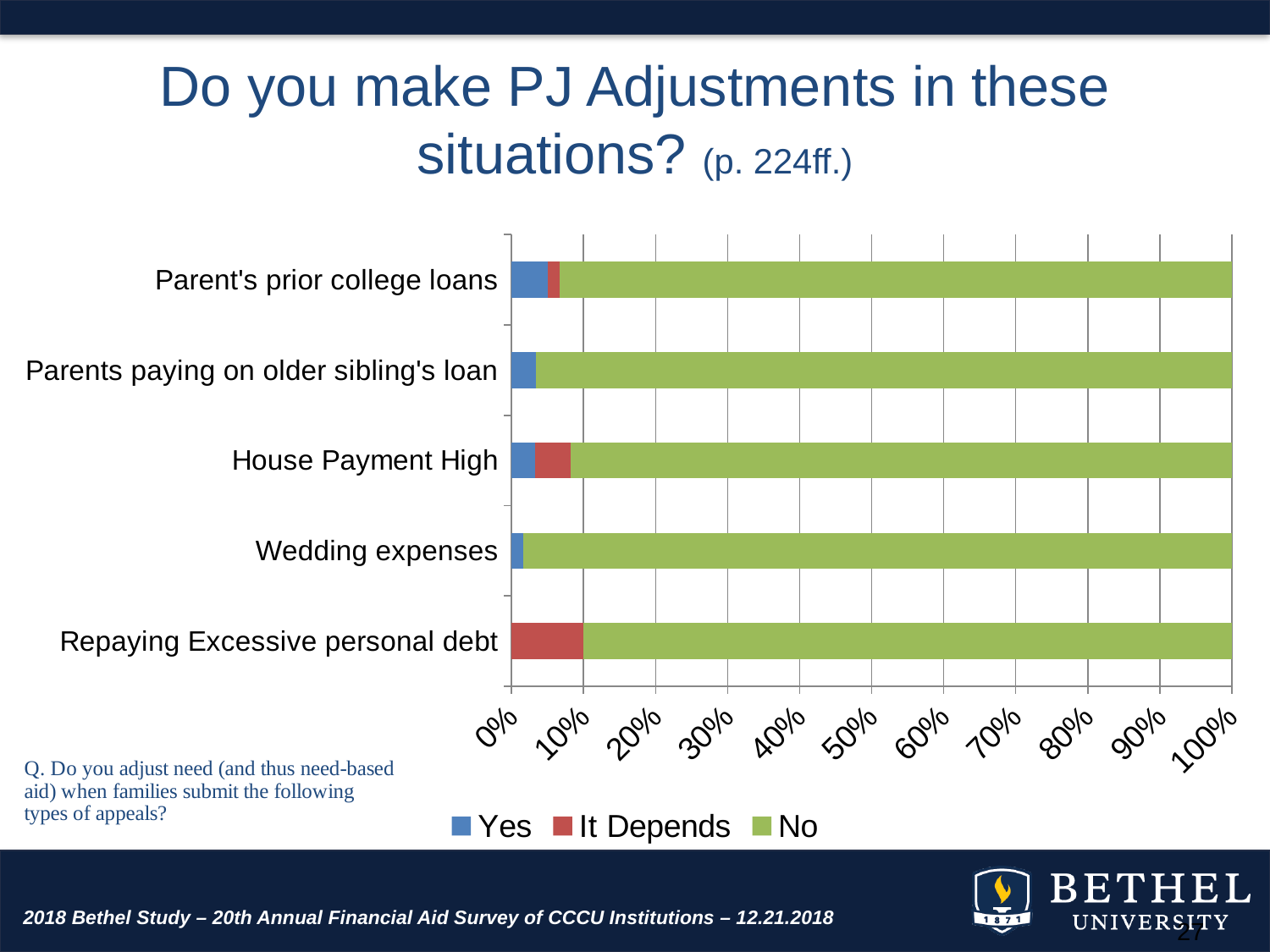
Is the "Yes" value for Parent's prior college loans greater or less than 10%? less Which colour represents the "No" responses in the chart? Green Is the "It Depends" value for Repaying Excessive personal debt greater or less than 20%? less Which category has the largest "It Depends" segment? Repaying Excessive personal debt Which category has the largest "No" segment? Wedding expenses How many series does the chart legend list? 3 What kind of chart is shown on the slide? Stacked bar chart What are the three series named in the legend? Yes, It Depends, No Is the "No" value for Wedding expenses greater or less than 90%? greater How many situations (categories) are listed on the chart? 5 Which category has the largest "Yes" segment? Parent's prior college loans Which has a larger "Yes" segment, Parent's prior college loans or Wedding expenses? Parent's prior college loans